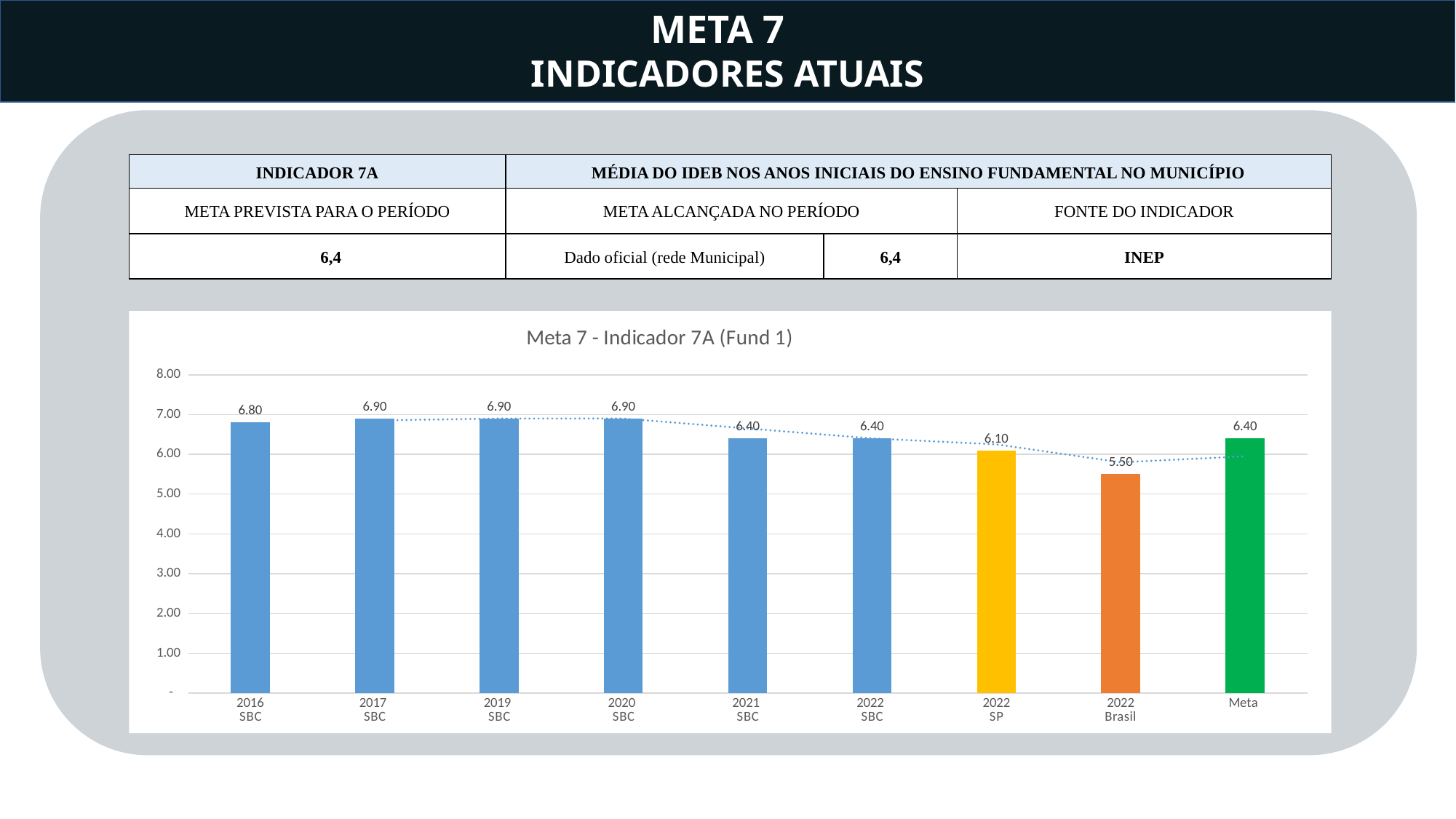
What kind of chart is shown on the slide? bar chart What is the value for 2022 SP in the chart? 6.10 Is the value for 2022 Brasil greater or less than 6.00? less What is the difference between the values for 2022 SBC and 2022 Brasil? 0.90 What is the value for 2022 Brasil in the chart? 5.50 How many bars are shown in the chart? 9 What is the title of the chart? Meta 7 - Indicador 7A (Fund 1) What is the difference between the values for 2020 SBC and 2021 SBC? 0.50 Which is larger, the value for 2022 SP or the value for 2022 Brasil? 2022 SP Which category has the lowest value in the chart? 2022 Brasil What is the value for 2016 SBC in the chart? 6.80 What is the value of the Meta bar in the chart? 6.40